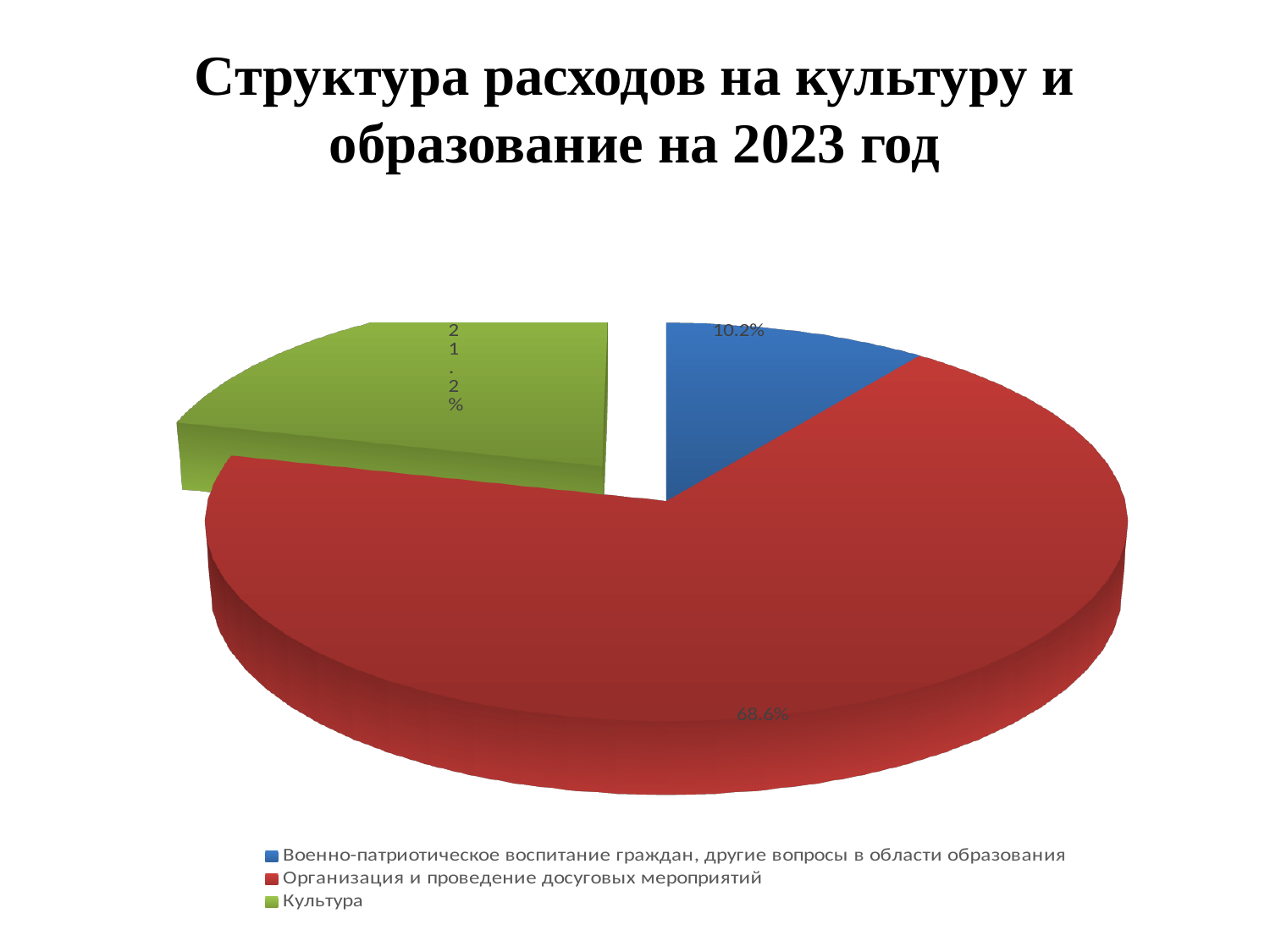
What share of the pie does the slice for Организация и проведение досуговых мероприятий have? 68.6% Which category has the smallest slice of the pie? Военно-патриотическое воспитание граждан, другие вопросы в области образования What is the difference in percentage points between the slice for Культура and the slice for Военно-патриотическое воспитание граждан, другие вопросы в области образования? 11.0 What share of the pie does the slice for Культура have? 21.2% How many slices does the pie chart have? 3 What is the title of the chart on the slide? Структура расходов на культуру и образование на 2023 год Which is larger: the slice for Культура or the slice for Военно-патриотическое воспитание граждан, другие вопросы в области образования? Культура What is the difference in percentage points between the slice for Организация и проведение досуговых мероприятий and the slice for Культура? 47.4 What kind of chart is shown on the slide? Pie chart What colour is the slice for Культура? Green Which category has the largest slice of the pie? Организация и проведение досуговых мероприятий What share of the pie does the slice for Военно-патриотическое воспитание граждан, другие вопросы в области образования have? 10.2%